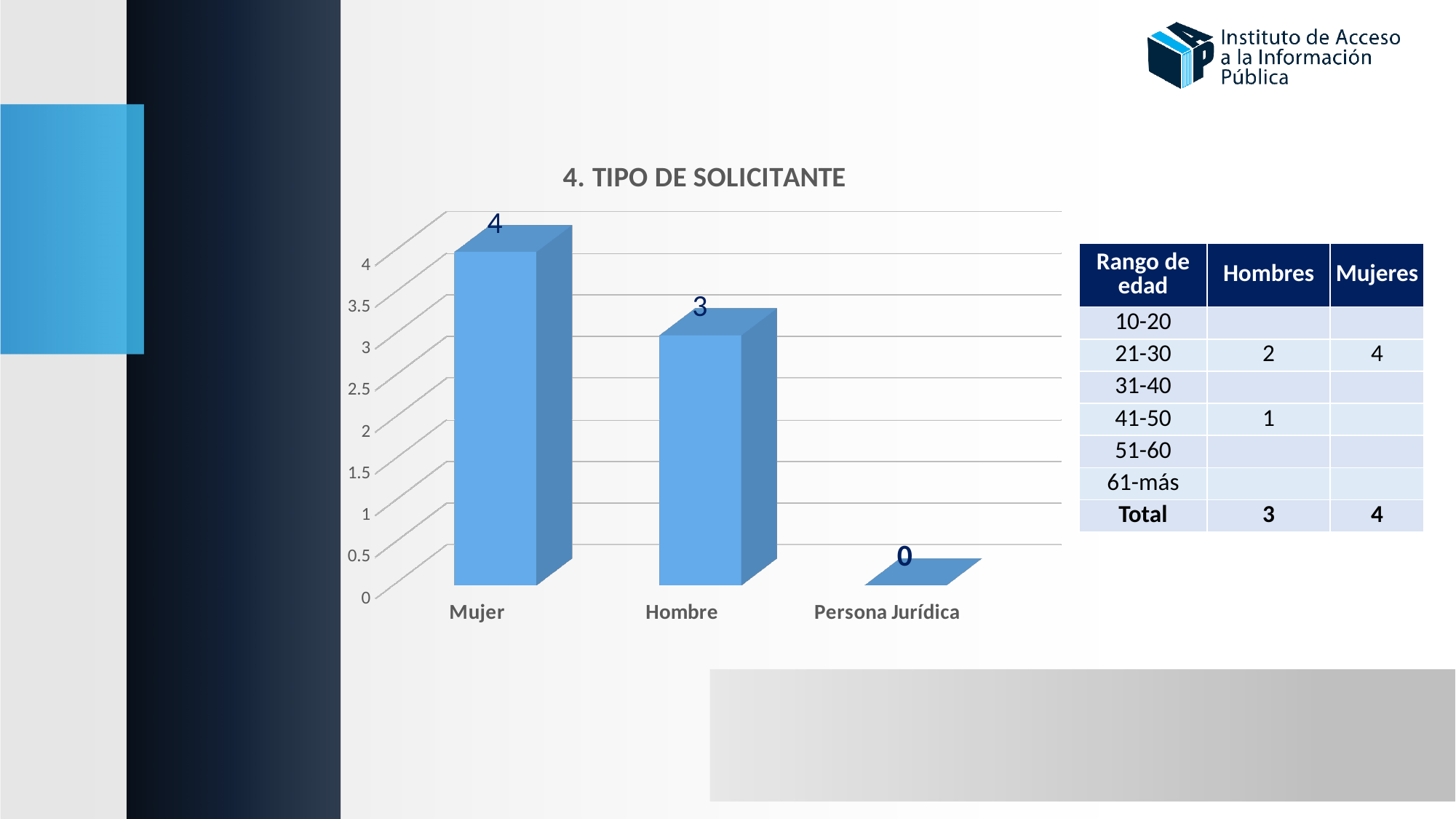
What is the value for Mujer in the chart? 4 Which category has the lowest value in the chart? Persona Jurídica What is the total of the values for Mujer, Hombre and Persona Jurídica? 7 What is the value for Persona Jurídica in the chart? 0 What is the value for Hombre in the chart? 3 Do the values rise or fall from left to right along the x axis? Fall Which category has the highest value in the chart? Mujer What is the title of the chart? 4. TIPO DE SOLICITANTE Which is larger, the value for Hombre or the value for Persona Jurídica? Hombre How many categories are shown on the x axis of the chart? 3 What is the difference between the values for Mujer and Hombre? 1 What kind of chart is shown on the slide? Bar chart